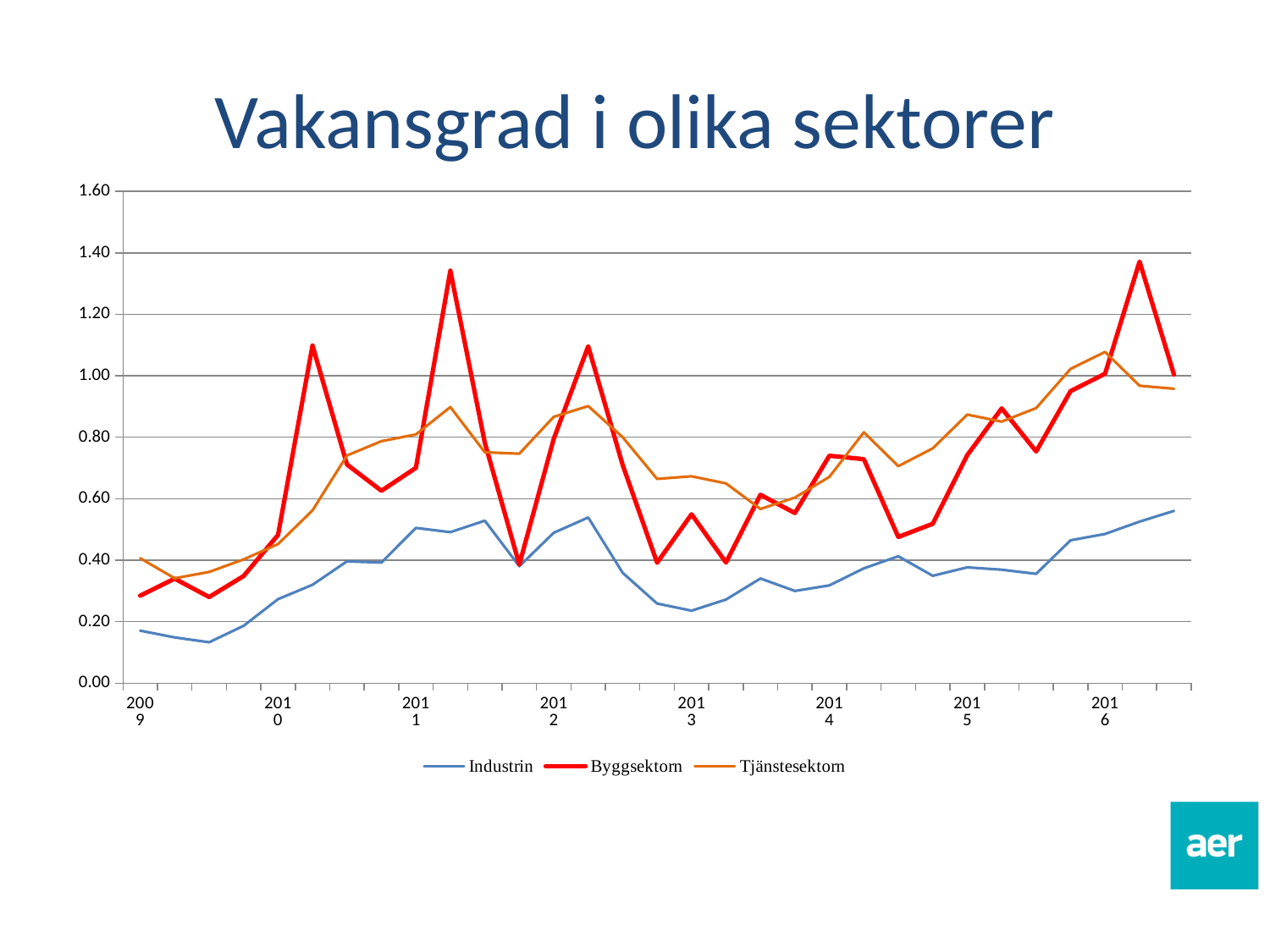
At the start of 2009, which is higher, Tjänstesektorn or Industrin? Tjänstesektorn What is the title of the chart? Vakansgrad i olika sektorer How many years are labelled on the x axis? 8 Is the value for Industrin at the start of 2009 greater or less than 0.20? less Is the highest peak of Byggsektorn in 2016 greater or less than 1.20? greater What kind of chart is shown on the slide? line chart Does the Industrin series generally rise or fall from 2013 to 2016? rise Which series is drawn in red? Byggsektorn Is the value for Industrin at the start of 2013 greater or less than 0.40? less Which series has the lowest values for most of the period shown? Industrin How many series does the legend list? 3